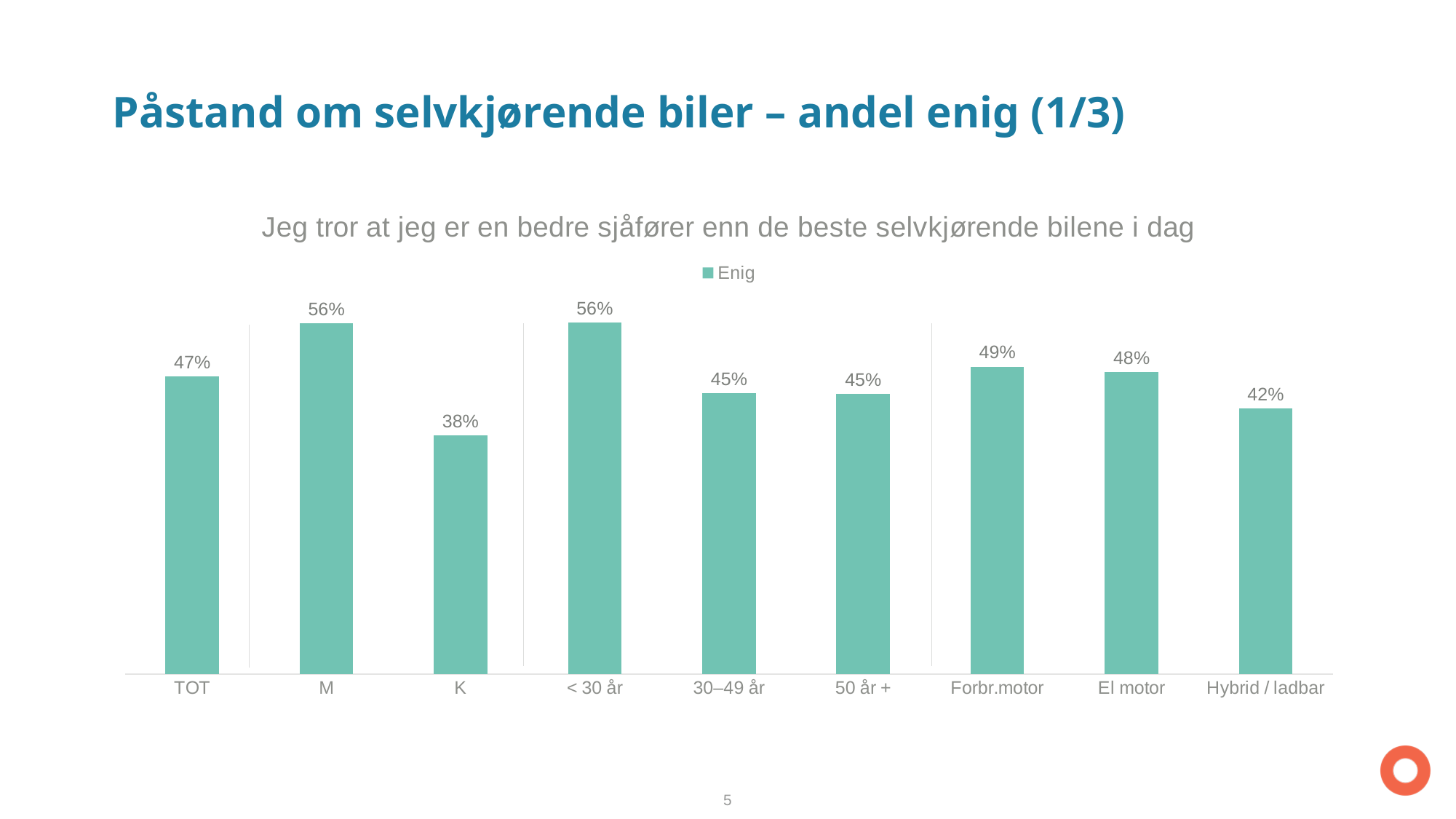
Which category has the lowest value? K Which is larger, the value for < 30 år or the value for 50 år +? < 30 år How many categories are shown on the x axis? 9 How many series does the legend list? 1 What is the value for Forbr.motor? 49% What is the difference between the values for El motor and Hybrid / ladbar? 6% What is the name of the series in the legend? Enig What kind of chart is shown? bar chart What is the difference between the values for M and K? 18% What is the value for Hybrid / ladbar? 42% What is the value for TOT? 47% What is the value for K? 38%